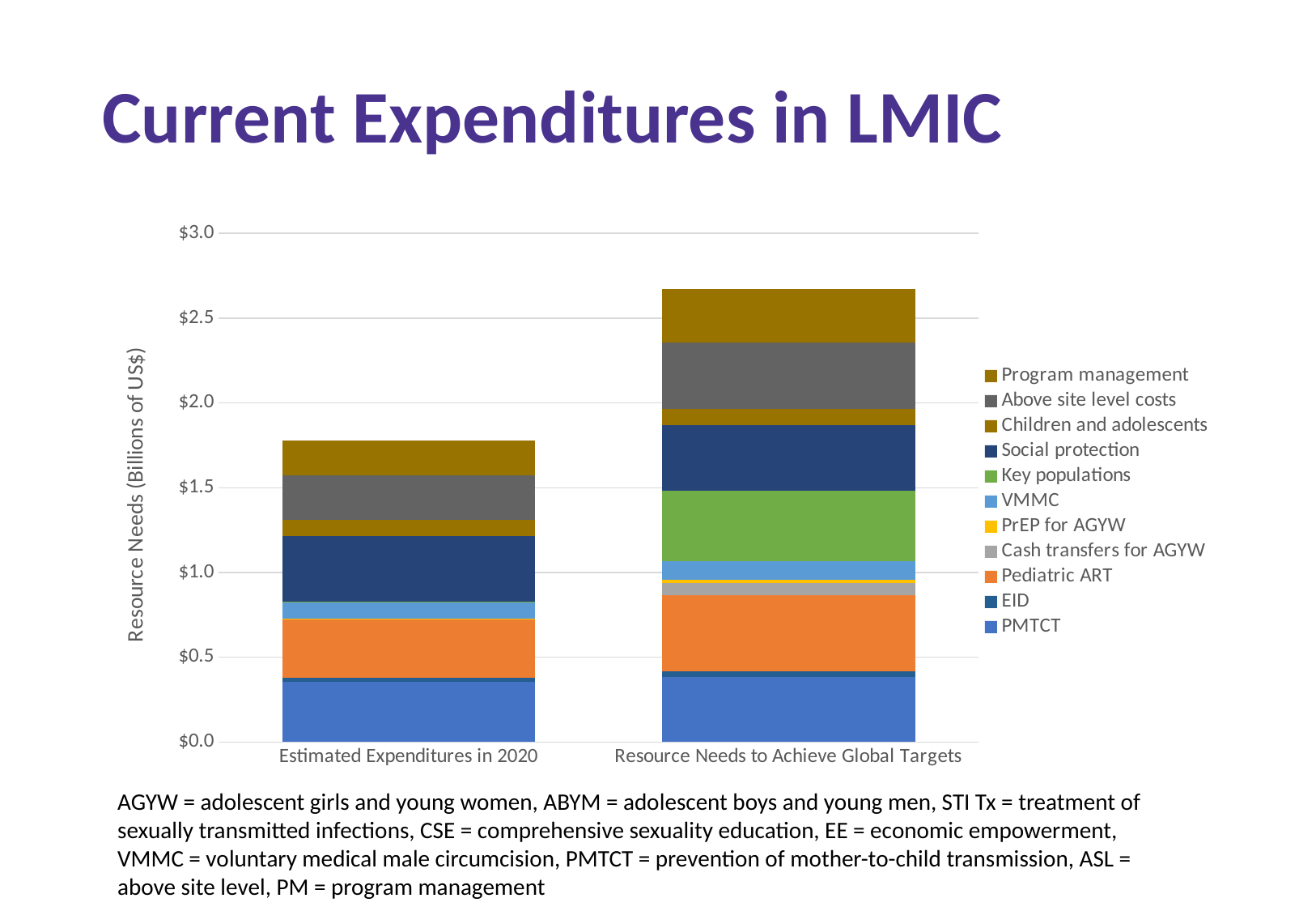
How many series does the legend list? 11 What kind of chart is shown on the slide? Stacked bar chart What is the label on the y axis? Resource Needs (Billions of US$) Is the total for Estimated Expenditures in 2020 greater or less than $2.0? less Is the total for Resource Needs to Achieve Global Targets greater or less than $2.5? greater Do the stacked totals rise or fall from the left bar to the right bar? rise Is the total for Estimated Expenditures in 2020 greater or less than $1.5? greater How many bars (categories) are plotted on the x axis? 2 Which series is listed at the bottom of the legend? PMTCT Which bar is taller, Estimated Expenditures in 2020 or Resource Needs to Achieve Global Targets? Resource Needs to Achieve Global Targets